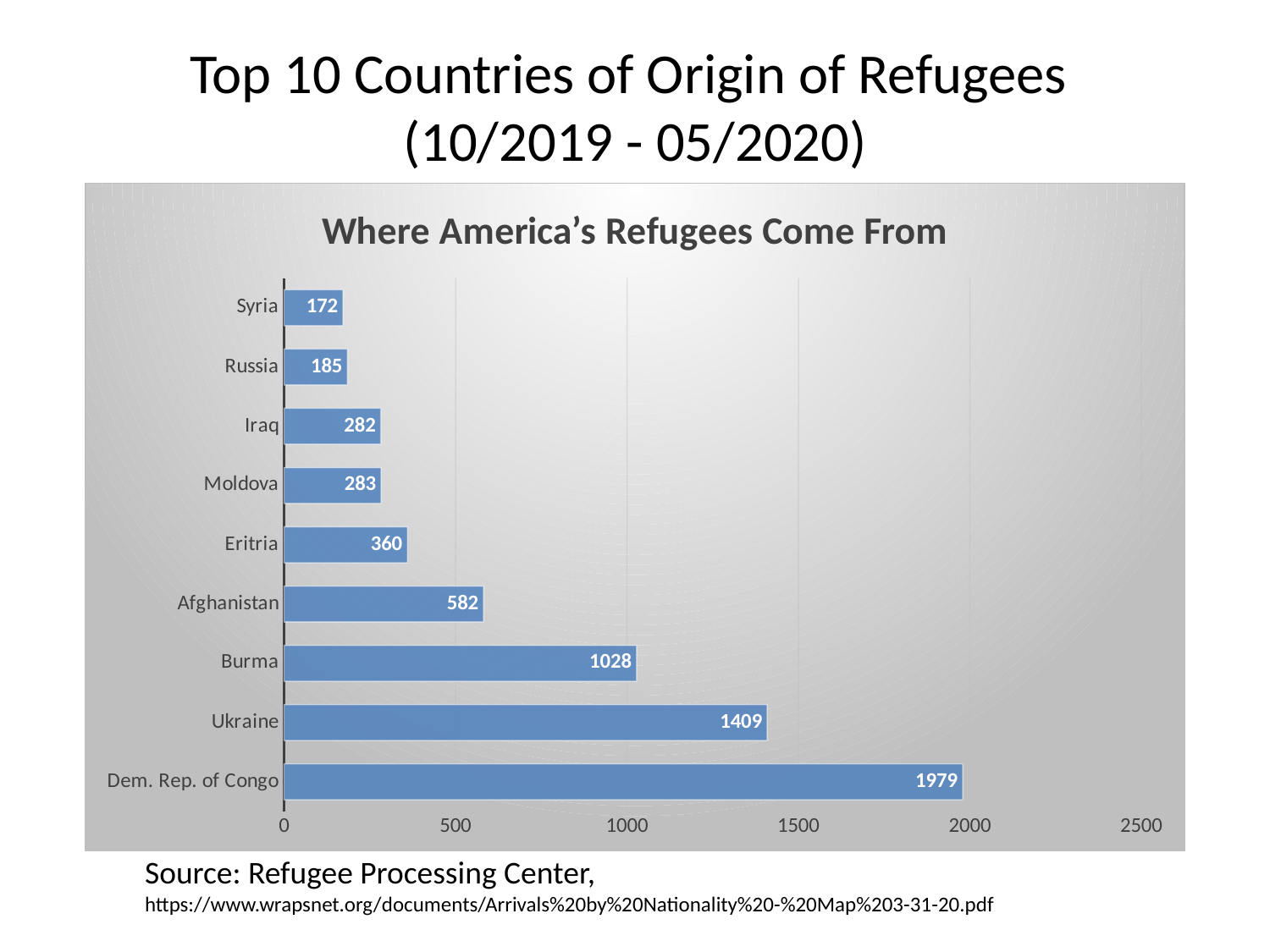
What is the title of the chart? Where America's Refugees Come From What is the difference between the values for Burma and Afghanistan? 446 What is the difference between the values for Dem. Rep. of Congo and Ukraine? 570 Is the value for Burma greater or less than 1000? greater How many countries are shown in the chart? 9 What is the value for Afghanistan? 582 What kind of chart is shown on the slide? bar chart Which is larger, the value for Eritria or the value for Iraq? Eritria What is the value for Moldova? 283 Which country has the highest value? Dem. Rep. of Congo What is the value for Ukraine? 1409 Which country has the lowest value? Syria